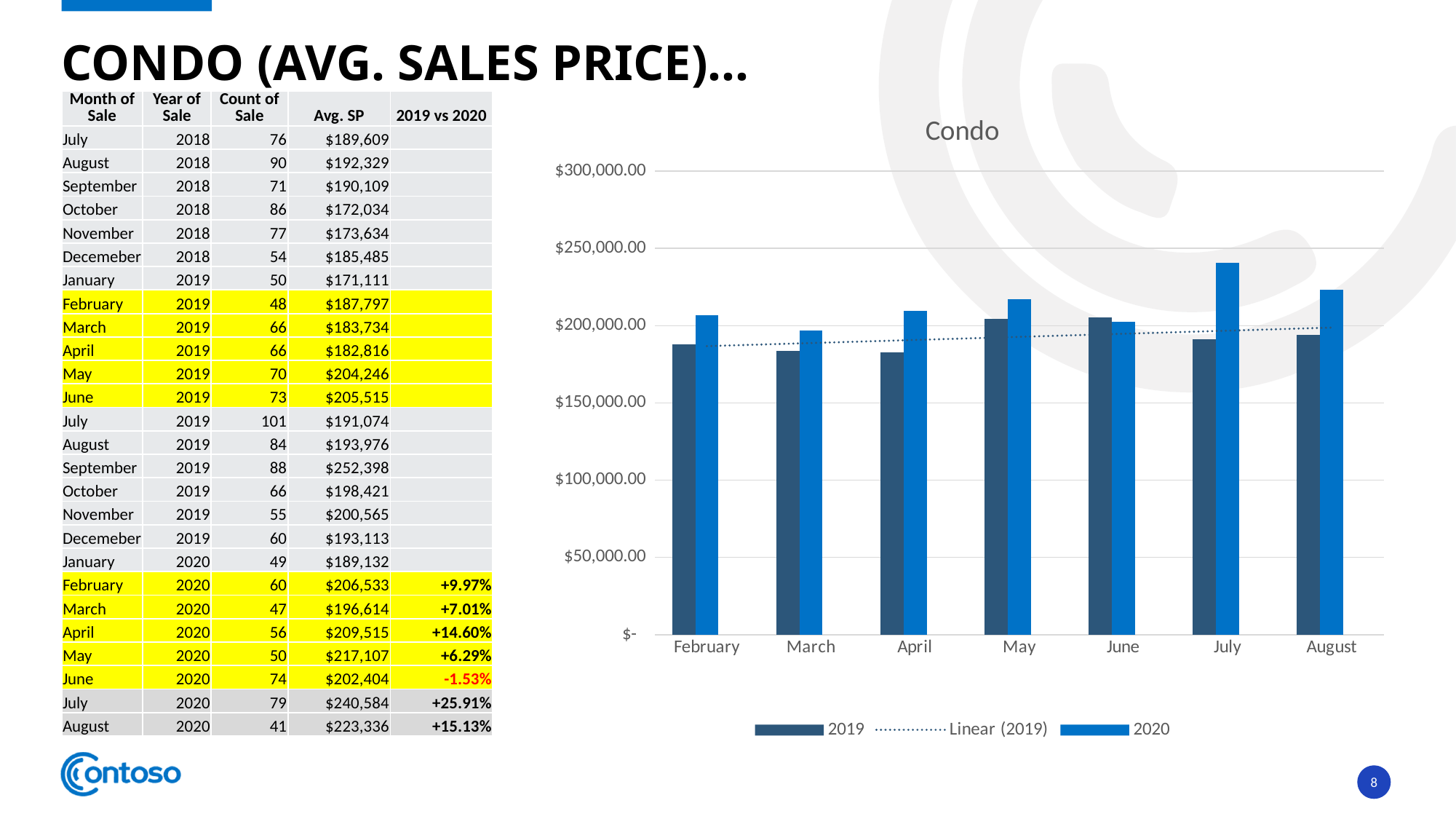
Is the 2020 value for July greater or less than $200,000.00? greater Is the 2020 value for August greater or less than $200,000.00? greater How many entries does the chart legend list? 3 Does the 2020 series rise or fall from June to July? rise Is the 2019 value for April greater or less than $200,000.00? less What is the title of the chart? Condo How many months are shown on the x axis of the chart? 7 For February, which series has the larger bar, 2019 or 2020? 2020 What kind of chart is shown on the slide? bar chart For July, which series has the larger bar, 2019 or 2020? 2020 Which month has the highest 2020 bar in the chart? July